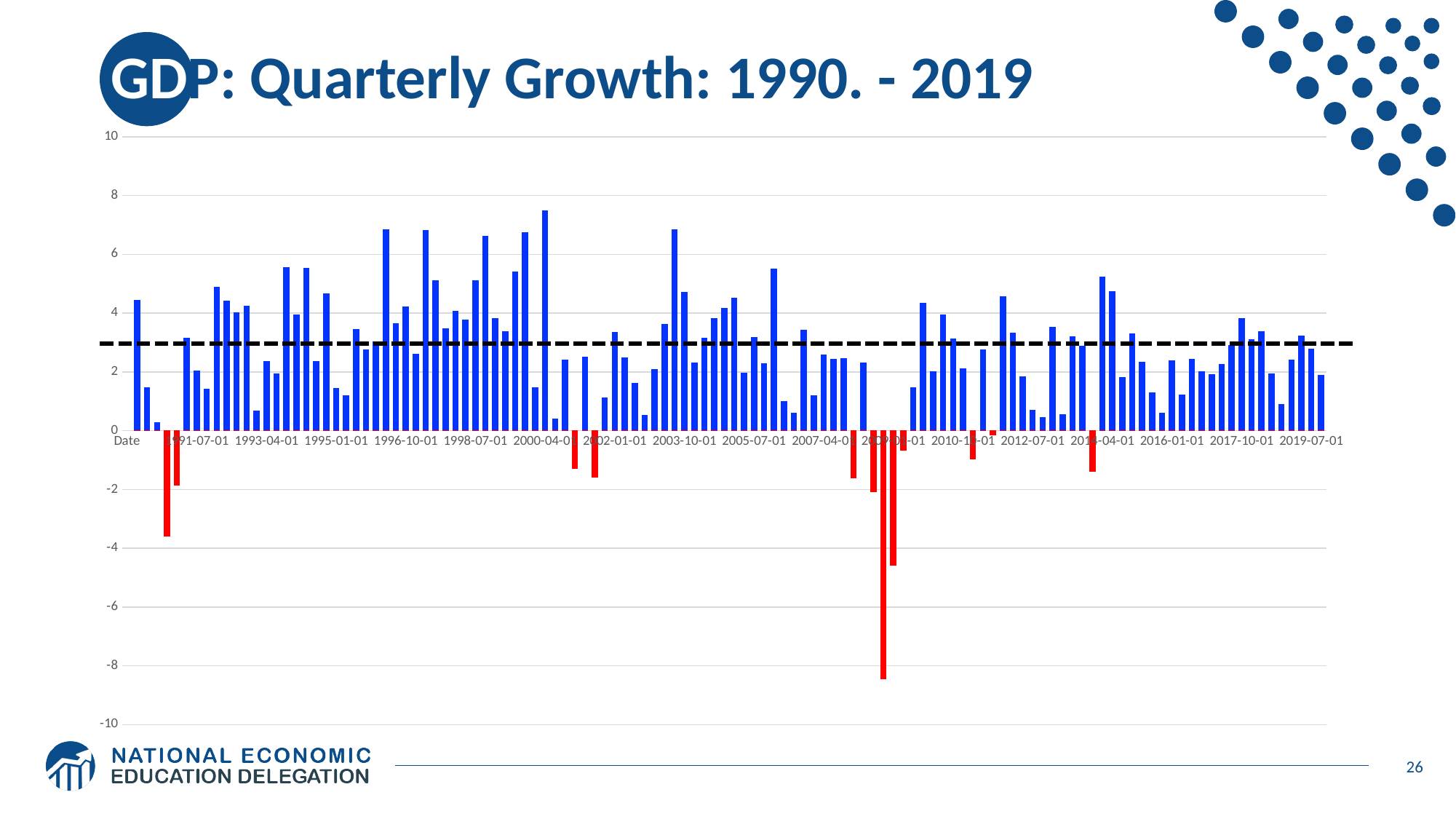
What is the last date label shown on the horizontal axis? 2019-07-01 What kind of chart is shown on the slide? bar chart What is the lowest value shown on the vertical axis? -10 What is the highest value shown on the vertical axis? 10 Is the lowest bar on the chart (the deepest negative quarter) greater or less than -8? less Is the tallest bar on the chart greater or less than 6? greater Is the tallest bar on the chart located before or after the 2002-01-01 label on the horizontal axis? before Is the deepest negative bar on the chart located closer to the 2009-01-01 label or the 1991-07-01 label? 2009-01-01 What is the title of the chart? GDP: Quarterly Growth: 1990. - 2019 What colour are the bars that show negative quarterly growth? red